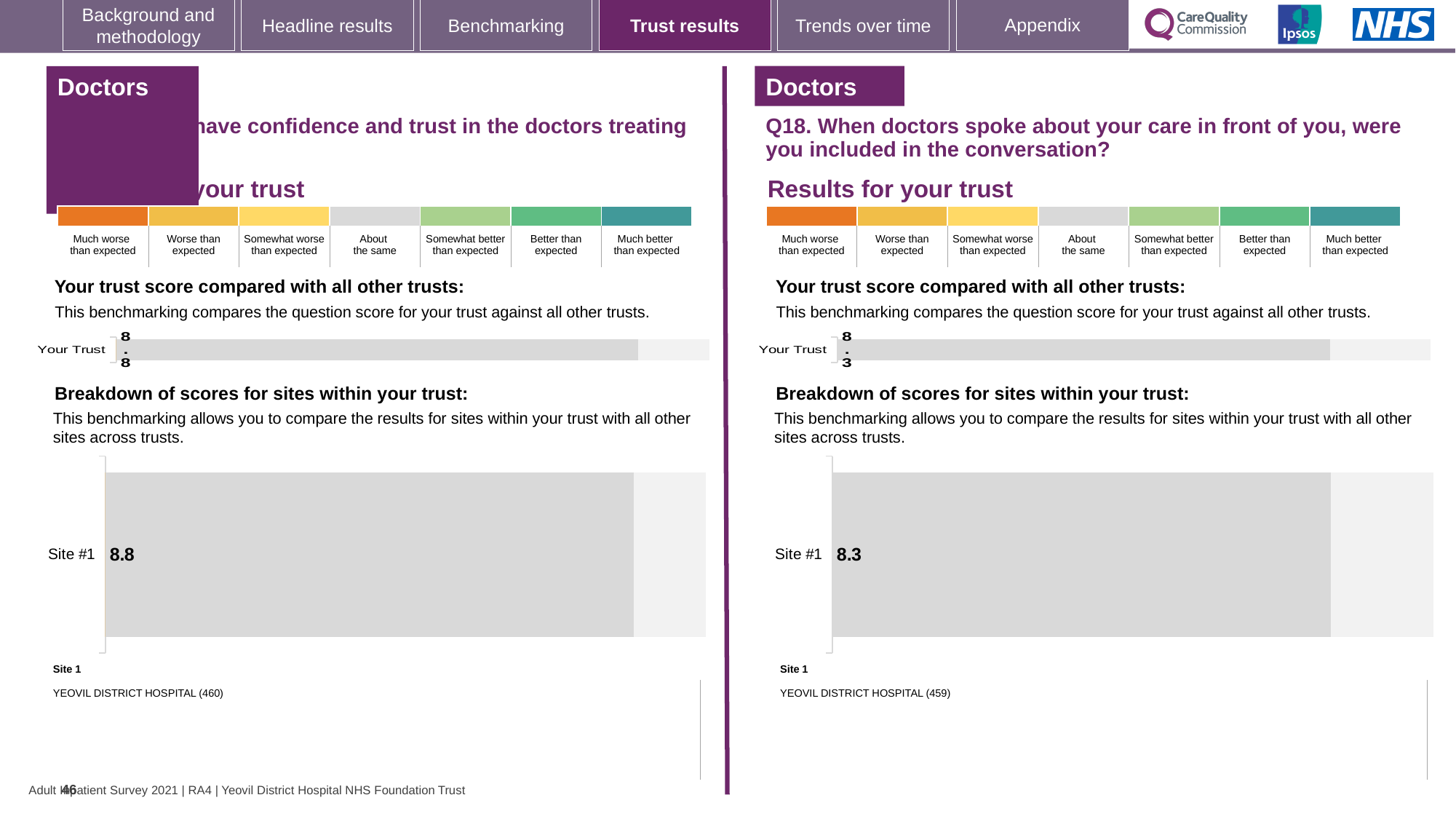
How many sites are shown in the breakdown of scores for sites within your trust on the left half of the slide? 1 Which is larger: the Site #1 score on the left half of the slide or the Site #1 score on the right half (Q18)? Left half (8.8) How many sites are shown in the breakdown of scores for sites within your trust on the right half of the slide (Q18)? 1 On the left half of the slide, what is the value shown for Your Trust in the 'Your trust score compared with all other trusts' chart? 8.8 On the right half of the slide (Q18), what is the score shown for Site #1 in the breakdown of scores for sites within your trust? 8.3 On the right half of the slide (Q18), what is the value shown for Your Trust in the 'Your trust score compared with all other trusts' chart? 8.3 What type of chart is used to show the breakdown of scores for sites within your trust on the right half of the slide (Q18)? Bar chart On the left half of the slide, what is the score shown for Site #1 in the breakdown of scores for sites within your trust? 8.8 What is the difference between the Site #1 score on the left half of the slide (8.8) and the Site #1 score on the right half (8.3)? 0.5 On the left half of the slide, which site is listed as Site 1 below the chart? YEOVIL DISTRICT HOSPITAL (460) On the right half of the slide (Q18), which site is listed as Site 1 below the chart? YEOVIL DISTRICT HOSPITAL (459)